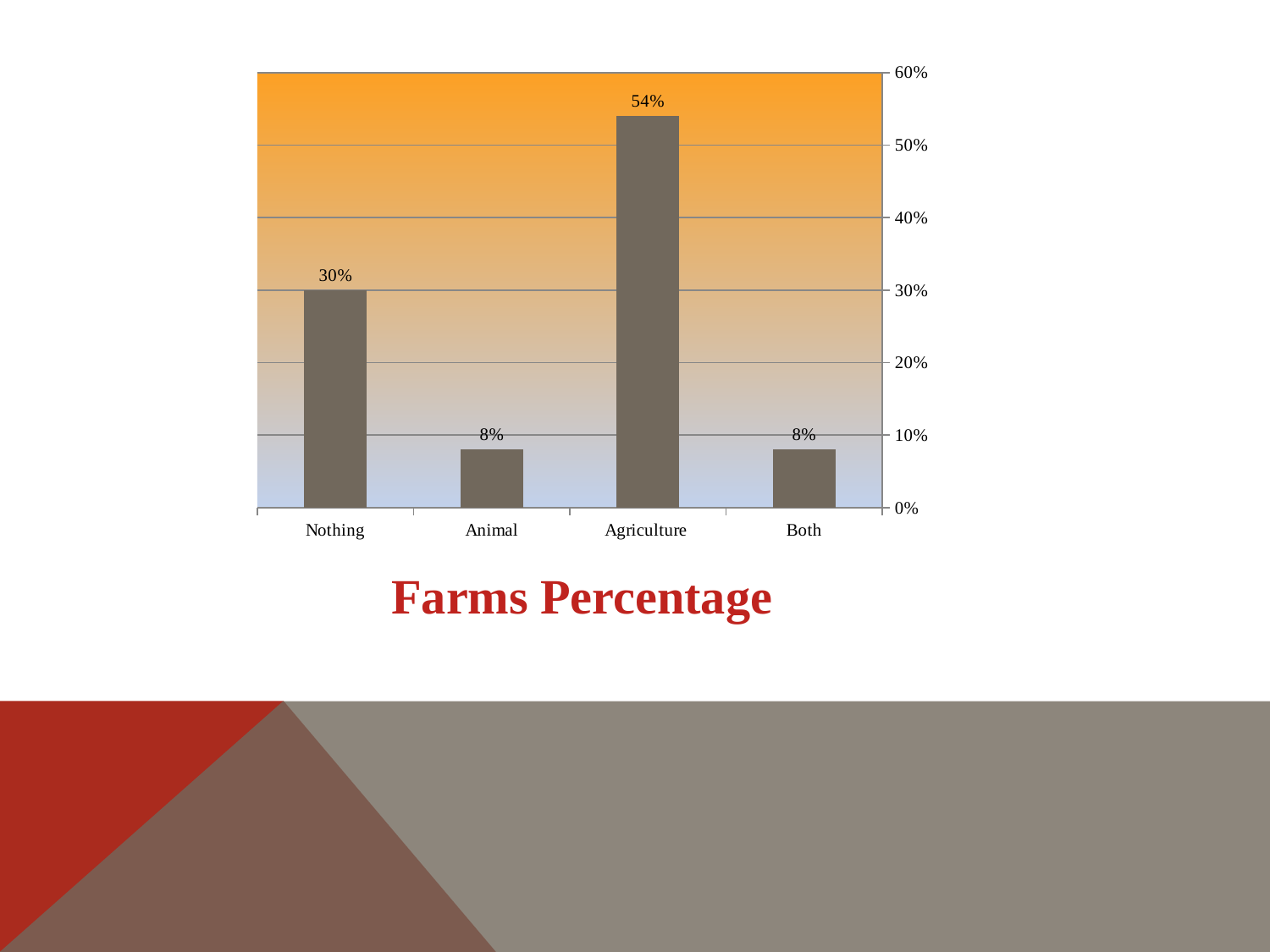
What is the value for Animal? 8% Is the value for Agriculture greater or less than 50%? greater What kind of chart is shown on the slide? bar chart What is the title shown below the chart? Farms Percentage Which category has the highest value? Agriculture How many categories are shown on the x axis? 4 What is the difference between the values for Nothing and Animal? 22% What is the value for Nothing? 30% What is the value for Agriculture? 54% Which is larger, the value for Nothing or the value for Both? Nothing What is the difference between the values for Agriculture and Nothing? 24% What is the value for Both? 8%